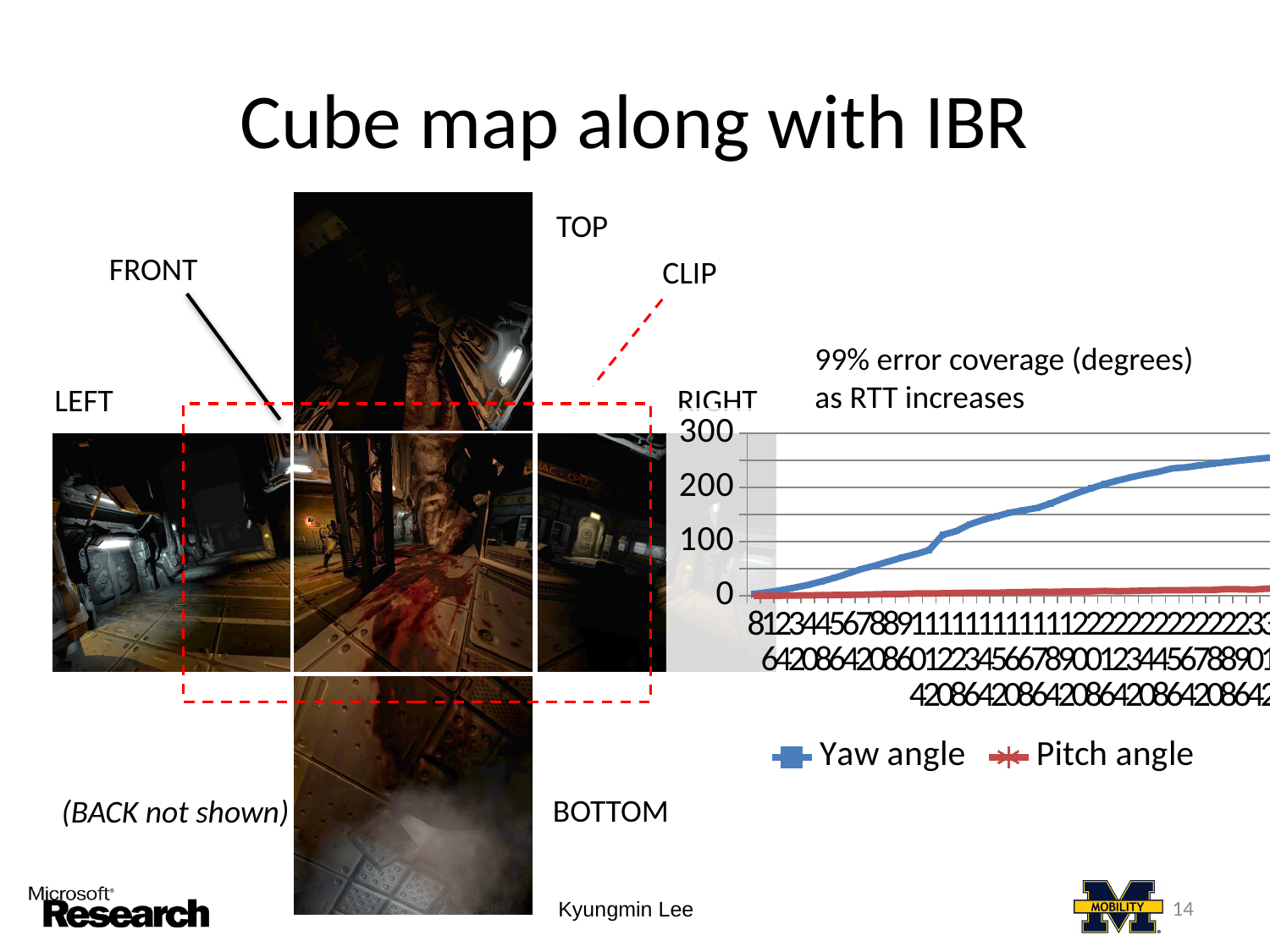
What is the title of the chart? 99% error coverage (degrees) as RTT increases Does the Yaw angle series rise or fall as RTT increases along the x axis? rise What kind of chart is shown on the slide? line chart Which series stays closest to 0 across the whole chart? Pitch angle Is the Yaw angle value at the right end of the chart greater or less than 200? greater How many series does the chart's legend list? 2 Which series has the larger values at the right end of the chart, Yaw angle or Pitch angle? Yaw angle Is the Pitch angle value at the right end of the chart greater or less than 100? less What is the highest value shown on the chart's vertical axis? 300 What are the two series named in the chart legend? Yaw angle and Pitch angle Is the Yaw angle value at the left end of the chart greater or less than 100? less